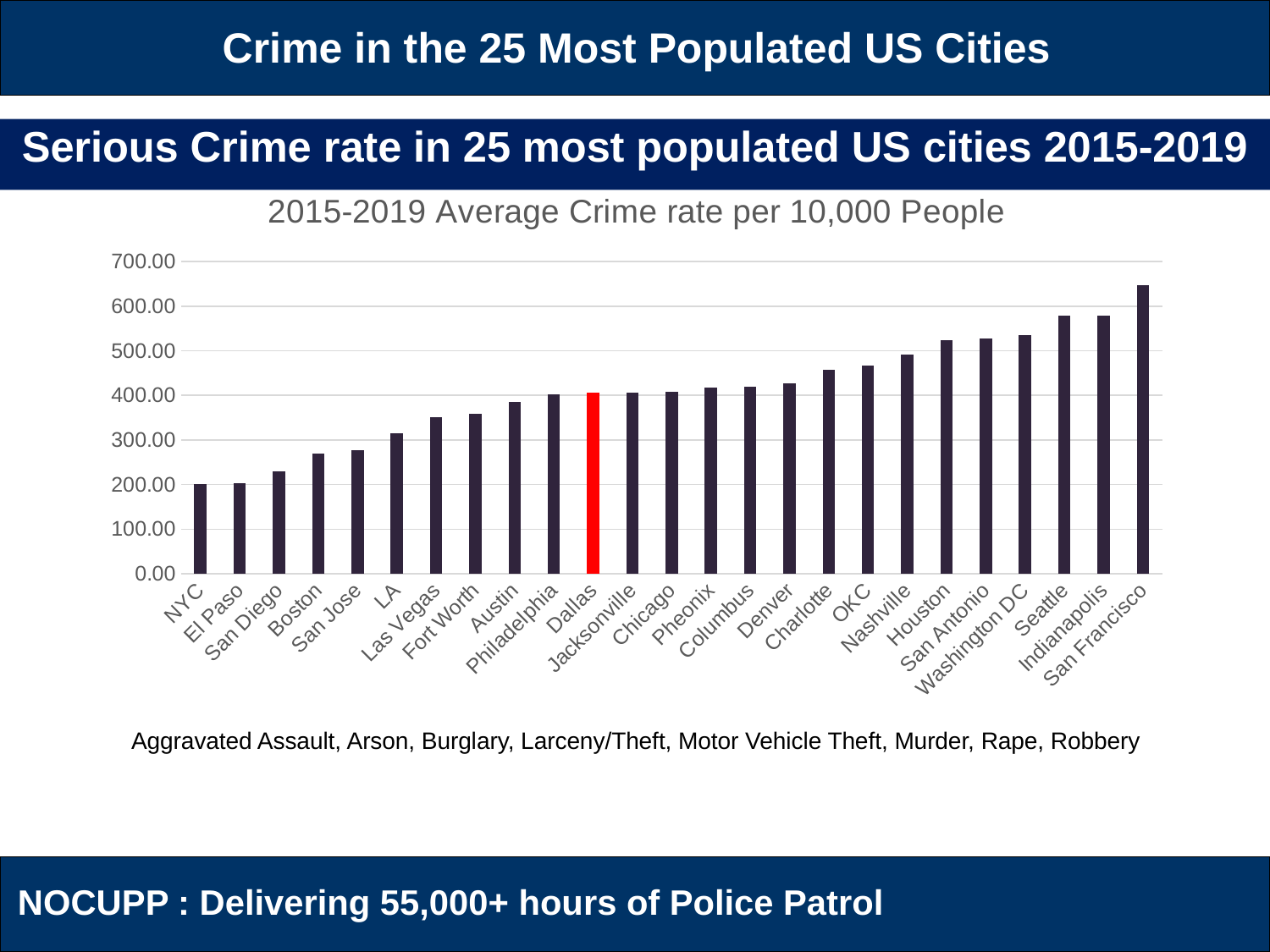
Which city's bar is highlighted in red? Dallas Which city has a higher average crime rate, Seattle or Dallas? Seattle Is the value for San Francisco greater or less than 600? greater How many cities are plotted on the chart? 25 Is the value for Houston greater or less than 500? greater Is the value for Charlotte greater or less than 400? greater What kind of chart is shown on the slide? bar chart Which city has the highest average crime rate per 10,000 people? San Francisco Which city has a higher average crime rate, Houston or Boston? Houston Do the bar values generally rise or fall from left to right along the x axis? rise